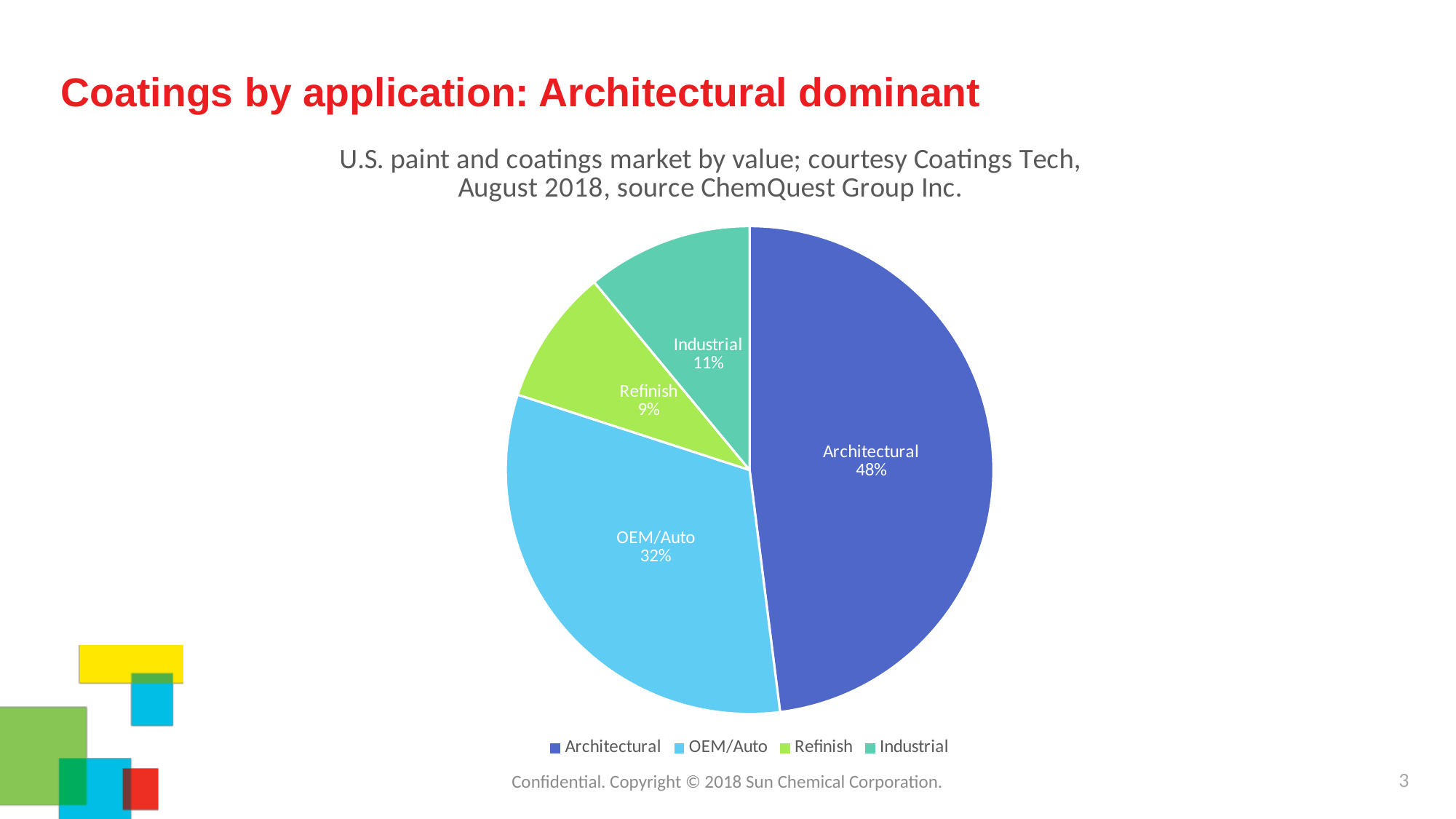
What share of the pie does Architectural hold? 48% Which category has the smallest slice of the pie? Refinish What is the value shown for Industrial? 11% How many categories are shown in the pie chart? 4 Which category has the largest slice of the pie? Architectural What kind of chart is shown on the slide? Pie chart What is the difference in percentage points between Architectural and OEM/Auto? 16 What is the title of the chart? U.S. paint and coatings market by value; courtesy Coatings Tech, August 2018, source ChemQuest Group Inc. How many entries does the legend list? 4 What is the value shown for OEM/Auto? 32% What is the value shown for Refinish? 9% Which is larger, Industrial or Refinish? Industrial